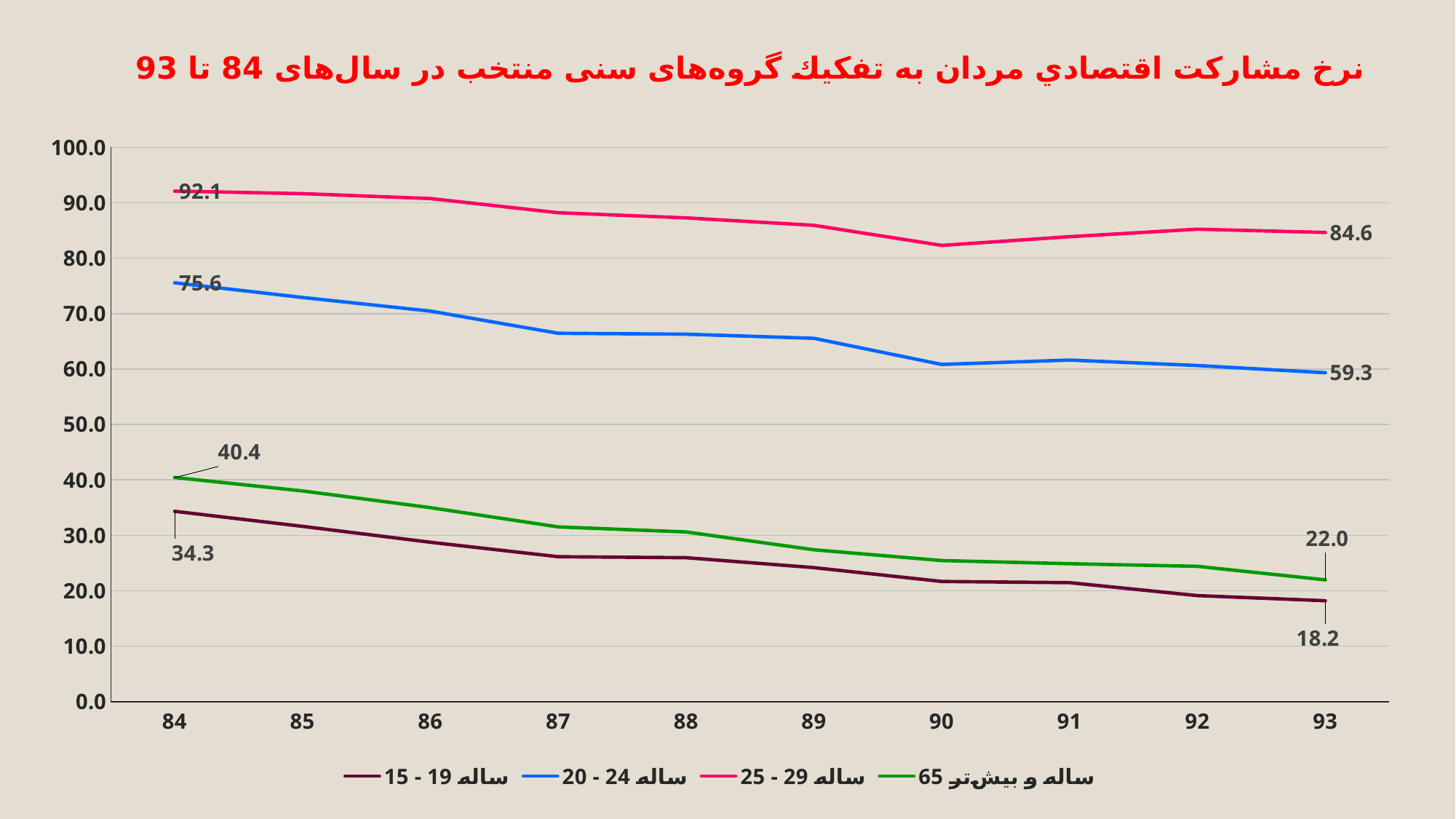
What kind of chart is shown on the slide? line chart Which series has the highest value in year 93? 25 - 29 ساله What is the value for the 15 - 19 ساله series in year 93? 18.2 How many years are shown on the x axis? 10 Is the value for the 20 - 24 ساله series in year 90 greater or less than 70.0? less How many series does the legend list? 4 What is the value for the 65 ساله و بیشتر series in year 84? 40.4 By how much did the value for the 25 - 29 ساله series fall from year 84 to year 93? 7.5 By how much did the value for the 20 - 24 ساله series fall from year 84 to year 93? 16.3 Which series has the lowest value in year 84? 15 - 19 ساله What is the value for the 25 - 29 ساله series in year 84? 92.1 What is the value for the 20 - 24 ساله series in year 93? 59.3